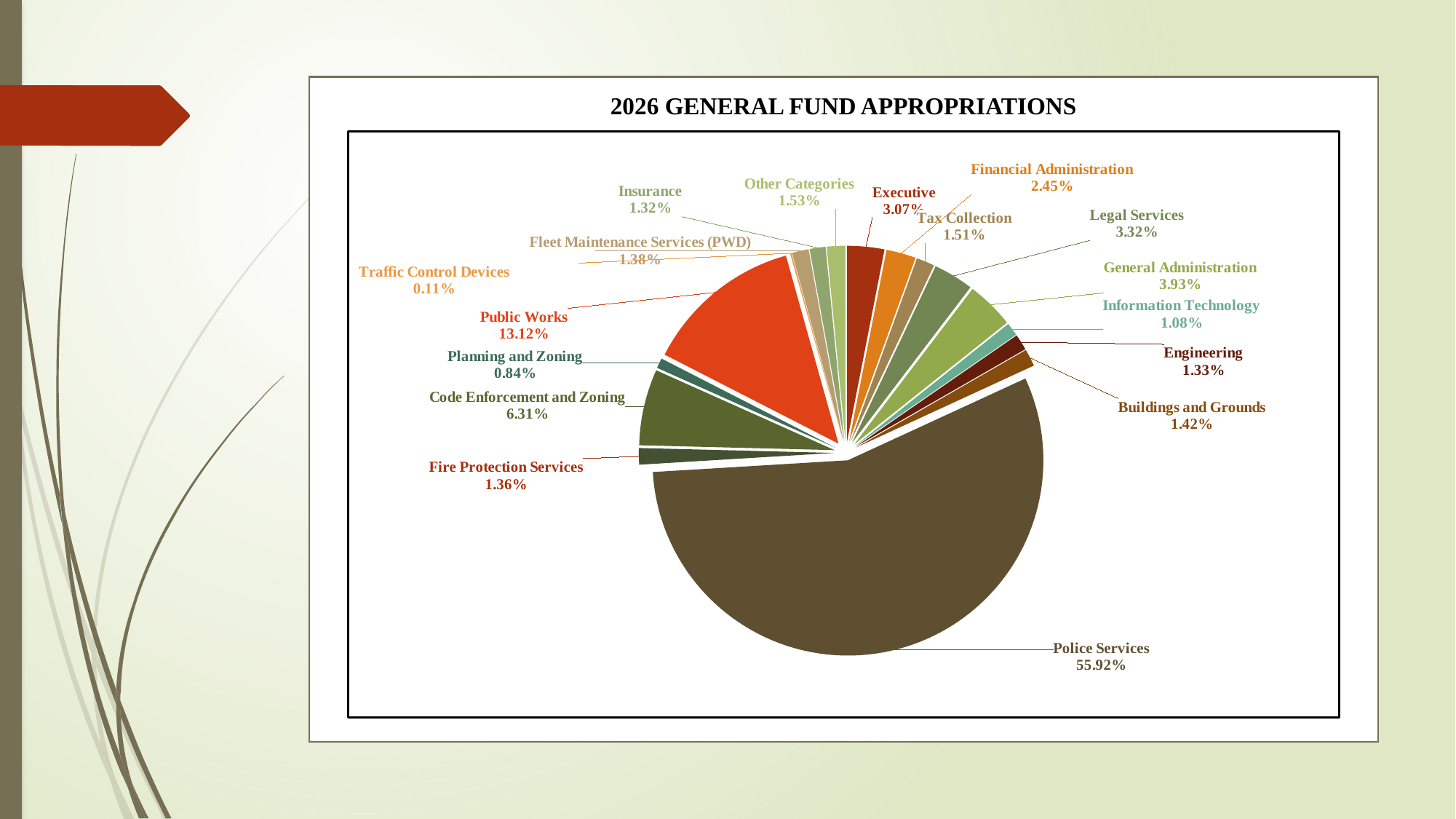
What is the title of the chart? 2026 GENERAL FUND APPROPRIATIONS What is the value shown for Information Technology? 1.08% What kind of chart is shown on the slide? pie chart What is the difference between the Public Works share and the Code Enforcement and Zoning share? 6.81% What is the value shown for Public Works? 13.12% What is the value shown for Financial Administration? 2.45% Which category has the smallest slice of the pie? Traffic Control Devices How many categories are shown in the pie chart? 17 What share of the pie does Police Services represent? 55.92% What is the value shown for Code Enforcement and Zoning? 6.31% Which is larger, Legal Services or General Administration? General Administration Which category has the largest slice of the pie? Police Services